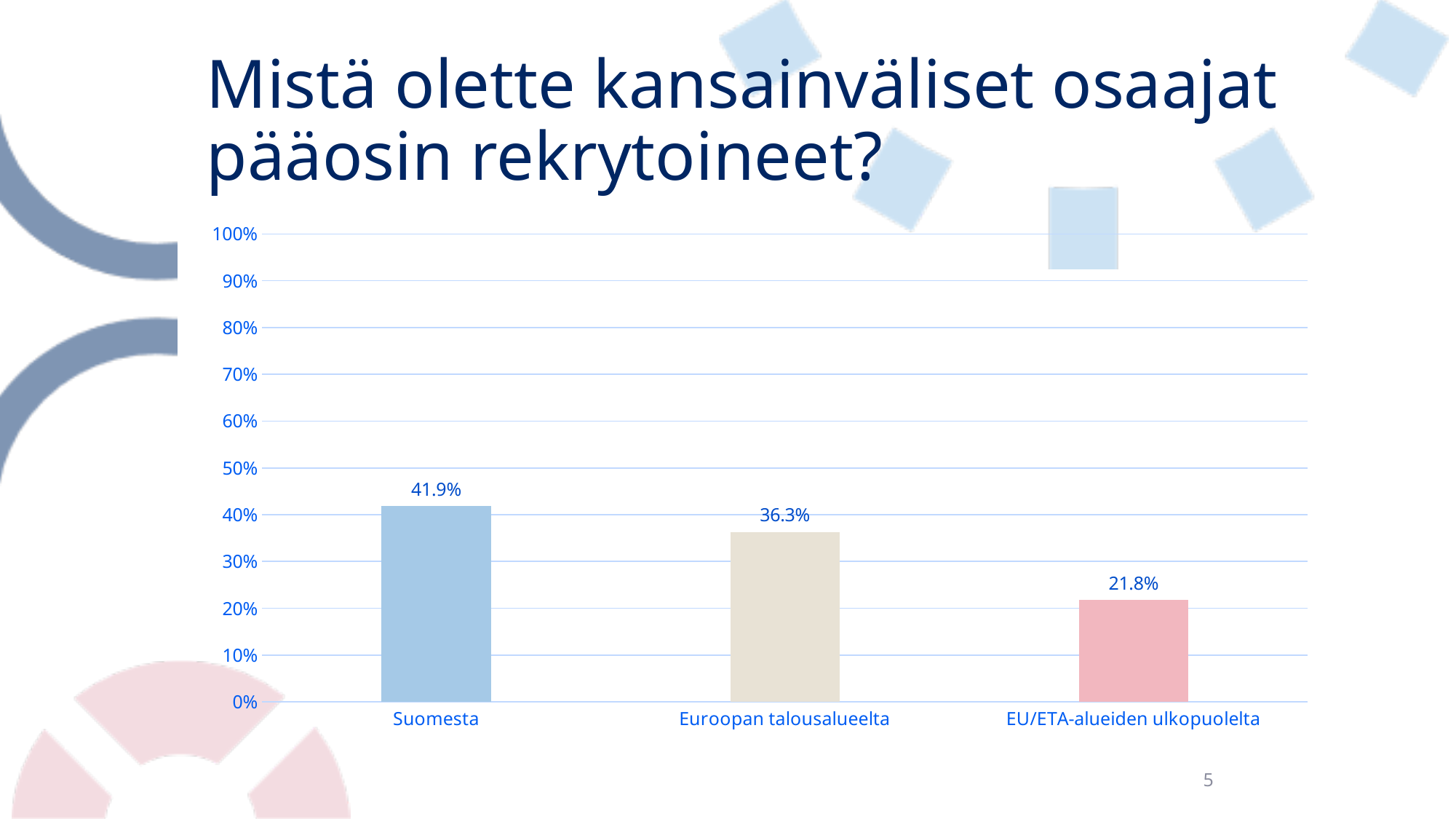
What is the difference between the values for Suomesta and Euroopan talousalueelta? 5.6% Which category has the highest value? Suomesta Which is larger, the value for Suomesta or the value for EU/ETA-alueiden ulkopuolelta? Suomesta What is the value for Suomesta? 41.9% How many categories are shown on the x axis? 3 What kind of chart is shown on the slide? bar chart Do the values rise or fall from left to right along the x axis? fall Which category has the lowest value? EU/ETA-alueiden ulkopuolelta Is the value for Euroopan talousalueelta greater or less than 40%? less What is the value for EU/ETA-alueiden ulkopuolelta? 21.8% What is the value for Euroopan talousalueelta? 36.3% What is the difference between the values for Euroopan talousalueelta and EU/ETA-alueiden ulkopuolelta? 14.5%